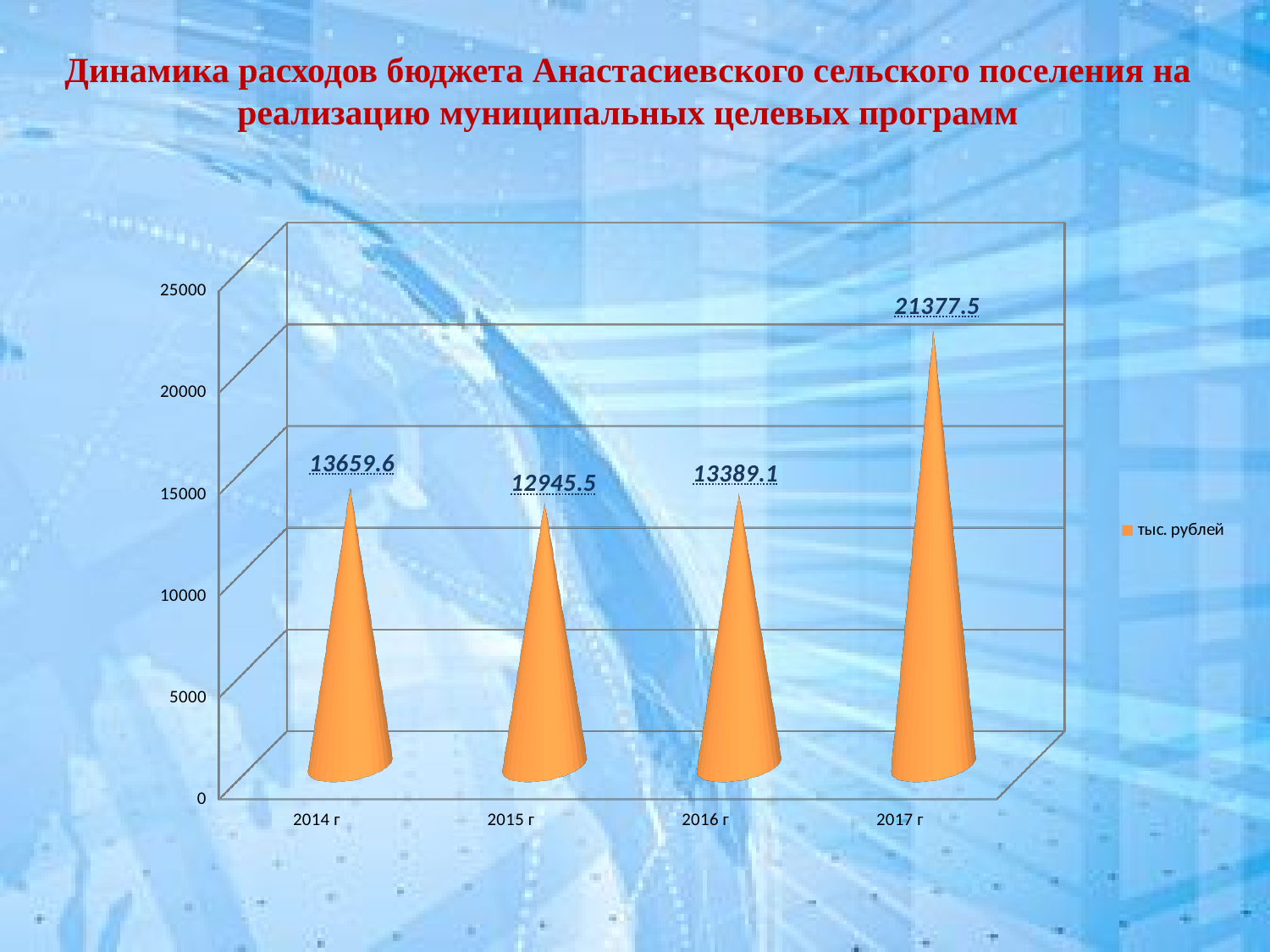
Which year has the highest value? 2017 г What is the legend entry of the chart? тыс. рублей What is the value for 2016 г? 13389.1 What is the difference between the values for 2017 г and 2014 г? 7717.9 Which year has the lowest value? 2015 г How many years are shown on the x axis? 4 What is the value for 2015 г? 12945.5 Which is larger, the value for 2014 г or the value for 2016 г? 2014 г Is the value for 2017 г greater or less than 20000? greater What is the value for 2014 г? 13659.6 What is the value for 2017 г? 21377.5 What kind of chart is shown on the slide? bar chart